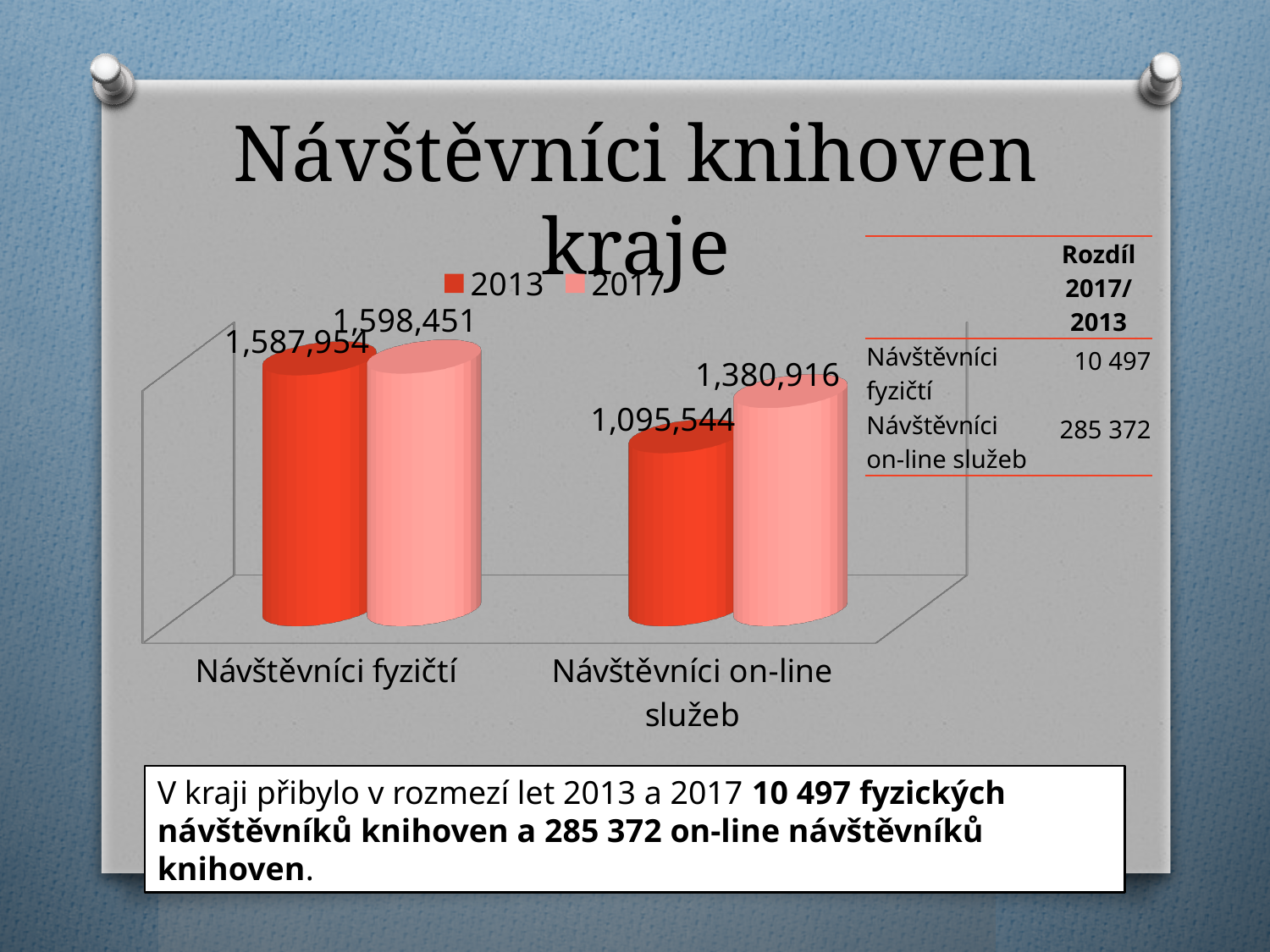
What kind of chart is shown on the slide? Bar chart Which category has the lowest value in 2013? Návštěvníci on-line služeb What is the value for Návštěvníci on-line služeb in 2013? 1,095,544 What is the difference between the 2017 and 2013 values for Návštěvníci on-line služeb? 285,372 How many categories are shown on the x axis of the chart? 2 Which category has the highest value in 2017? Návštěvníci fyzičtí What is the difference between the 2017 and 2013 values for Návštěvníci fyzičtí? 10,497 Which is larger for Návštěvníci on-line služeb: the 2013 value or the 2017 value? 2017 What is the value for Návštěvníci fyzičtí in 2017? 1,598,451 What is the value for Návštěvníci on-line služeb in 2017? 1,380,916 How many series does the chart legend list? 2 What is the value for Návštěvníci fyzičtí in 2013? 1,587,954